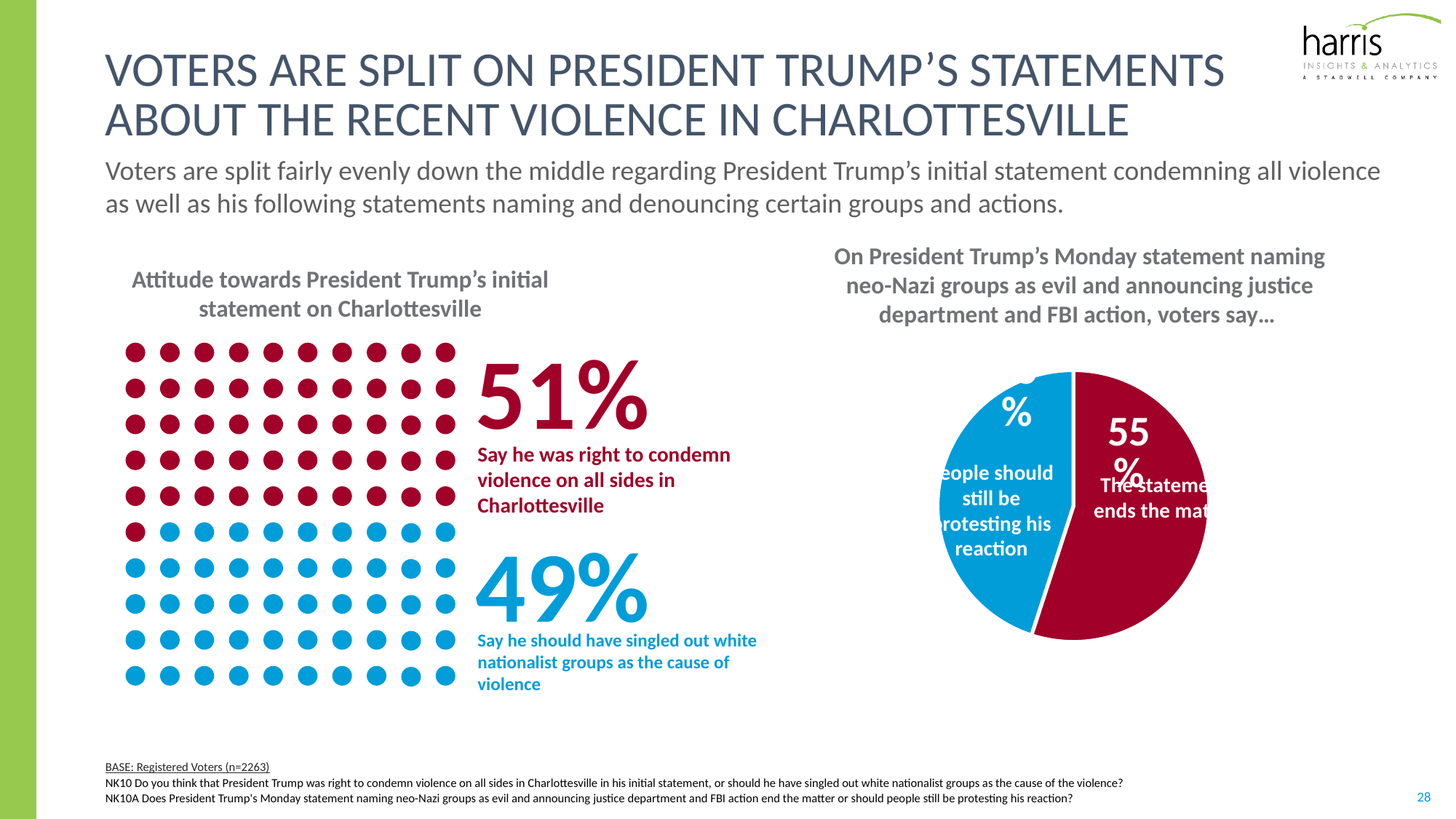
On the pie chart on the right, is the blue slice (people should still be protesting his reaction) greater or less than 50%? less In the left-hand graphic, what is the difference in percentage points between those who say he was right to condemn violence on all sides (51%) and those who say he should have singled out white nationalist groups (49%)? 2 percentage points In the left-hand graphic, what colour are the dots representing voters who say he should have singled out white nationalist groups? Blue What is the title of the left-hand graphic? Attitude towards President Trump's initial statement on Charlottesville On the pie chart on the right, what colour is the slice for 'the statement ends the matter'? Red On the pie chart on the right, which slice is larger: the red slice (the statement ends the matter) or the blue slice (people should still be protesting his reaction)? The red slice (the statement ends the matter) On the pie chart on the right, what share of voters say the statement ends the matter? 55% How many slices does the pie chart on the right have? 2 In the left-hand graphic on attitudes towards President Trump's initial statement, what percentage say he was right to condemn violence on all sides in Charlottesville? 51% In the left-hand graphic, which response is larger: 'right to condemn violence on all sides' or 'should have singled out white nationalist groups'? Right to condemn violence on all sides (51%) In the left-hand graphic on attitudes towards President Trump's initial statement, what percentage say he should have singled out white nationalist groups as the cause of violence? 49% What kind of chart is shown on the right side of the slide? Pie chart